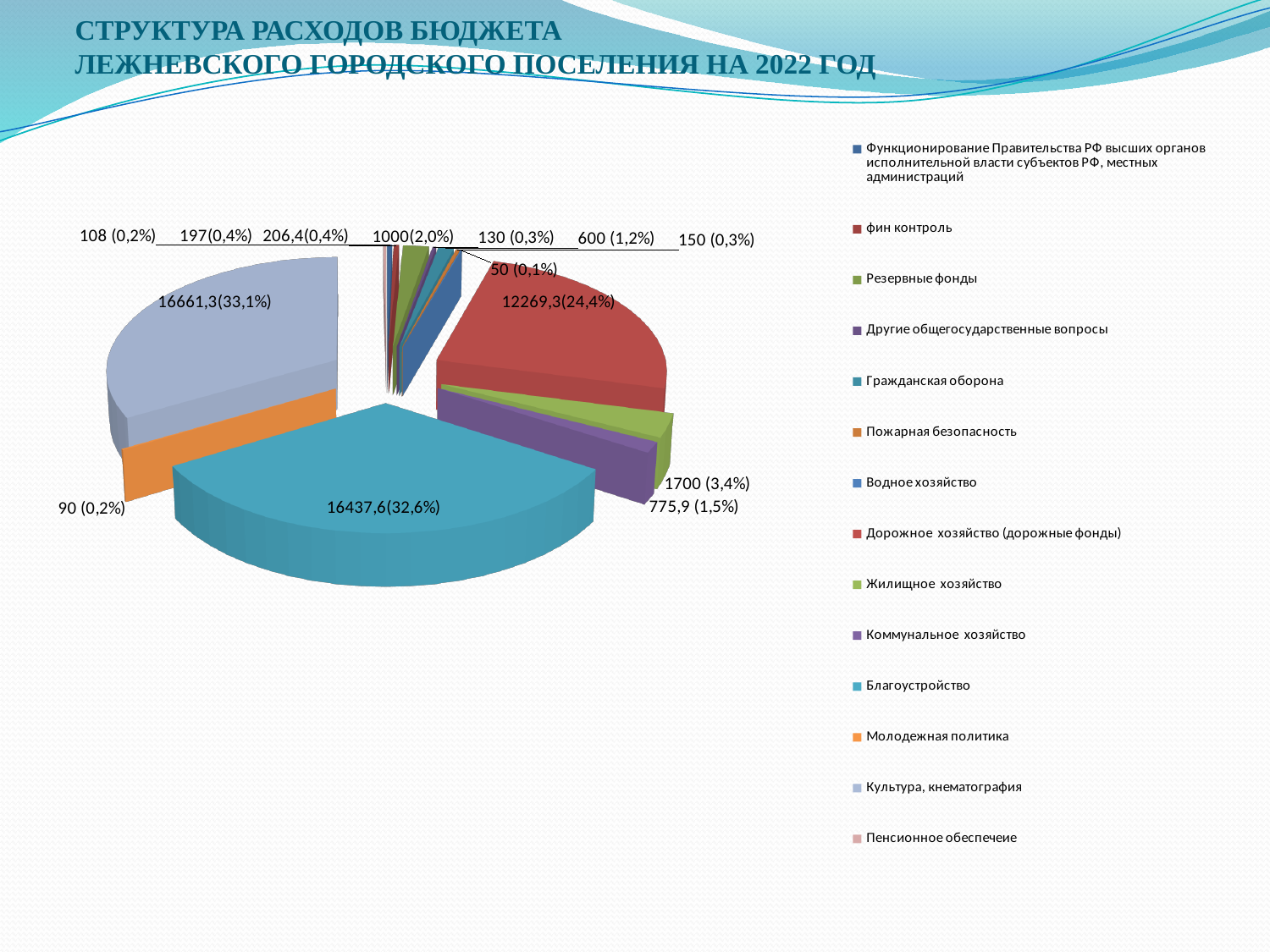
What value is shown for Дорожное хозяйство (дорожные фонды)? 12269,3(24,4%) What value is shown for Молодежная политика? 90 (0,2%) Which is larger, the value for Культура, кнематография or the value for Благоустройство? Культура, кнематография How many categories does the legend of the pie chart list? 14 What value is shown for Благоустройство? 16437,6(32,6%) What value is shown for Культура, кнематография? 16661,3(33,1%) What share of the pie does Дорожное хозяйство (дорожные фонды) take? 24,4% What kind of chart is shown on the slide? pie chart Which category has the largest slice of the pie? Культура, кнематография What is the difference between the values for Культура, кнематография (16661,3) and Благоустройство (16437,6)? 223,7 What is the smallest value labelled on the pie chart? 50 (0,1%) What is the title of the slide? СТРУКТУРА РАСХОДОВ БЮДЖЕТА ЛЕЖНЕВСКОГО ГОРОДСКОГО ПОСЕЛЕНИЯ НА 2022 ГОД